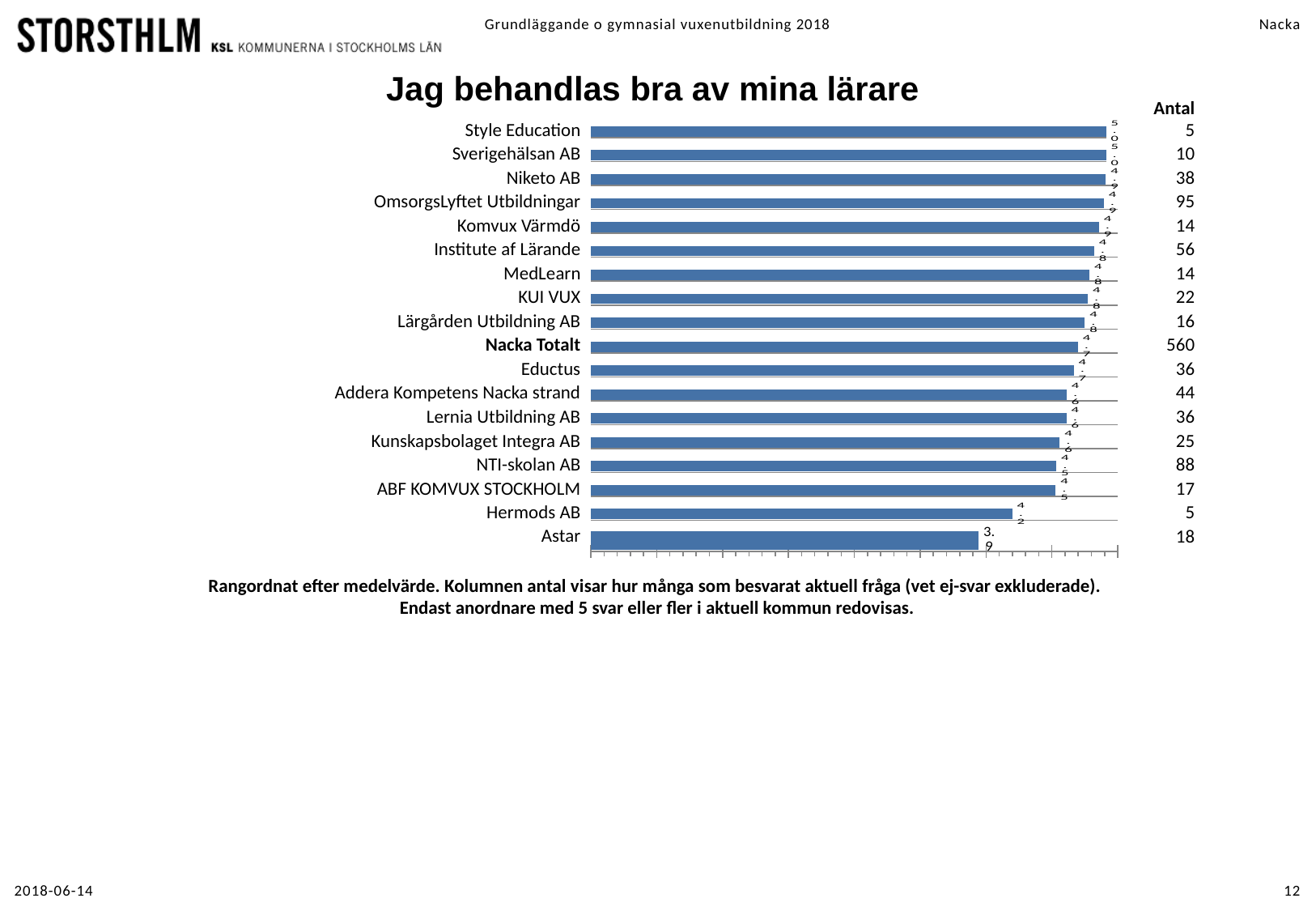
What is the value shown for Astar? 3.9 What is the value shown for Nacka Totalt? 4.7 What is the value shown for Hermods AB? 4.2 What kind of chart is shown on the slide? bar chart What is the difference between the values for Style Education and Astar? 1.1 Which has a larger value, Style Education or Hermods AB? Style Education What is the value shown for Style Education? 5.0 Do the bar values rise or fall going from the top of the chart to the bottom? fall Which has a larger value, Hermods AB or Astar? Hermods AB What is the title of the chart? Jag behandlas bra av mina lärare Which category has the lowest value in the chart? Astar How many categories (providers) are plotted in the chart? 18